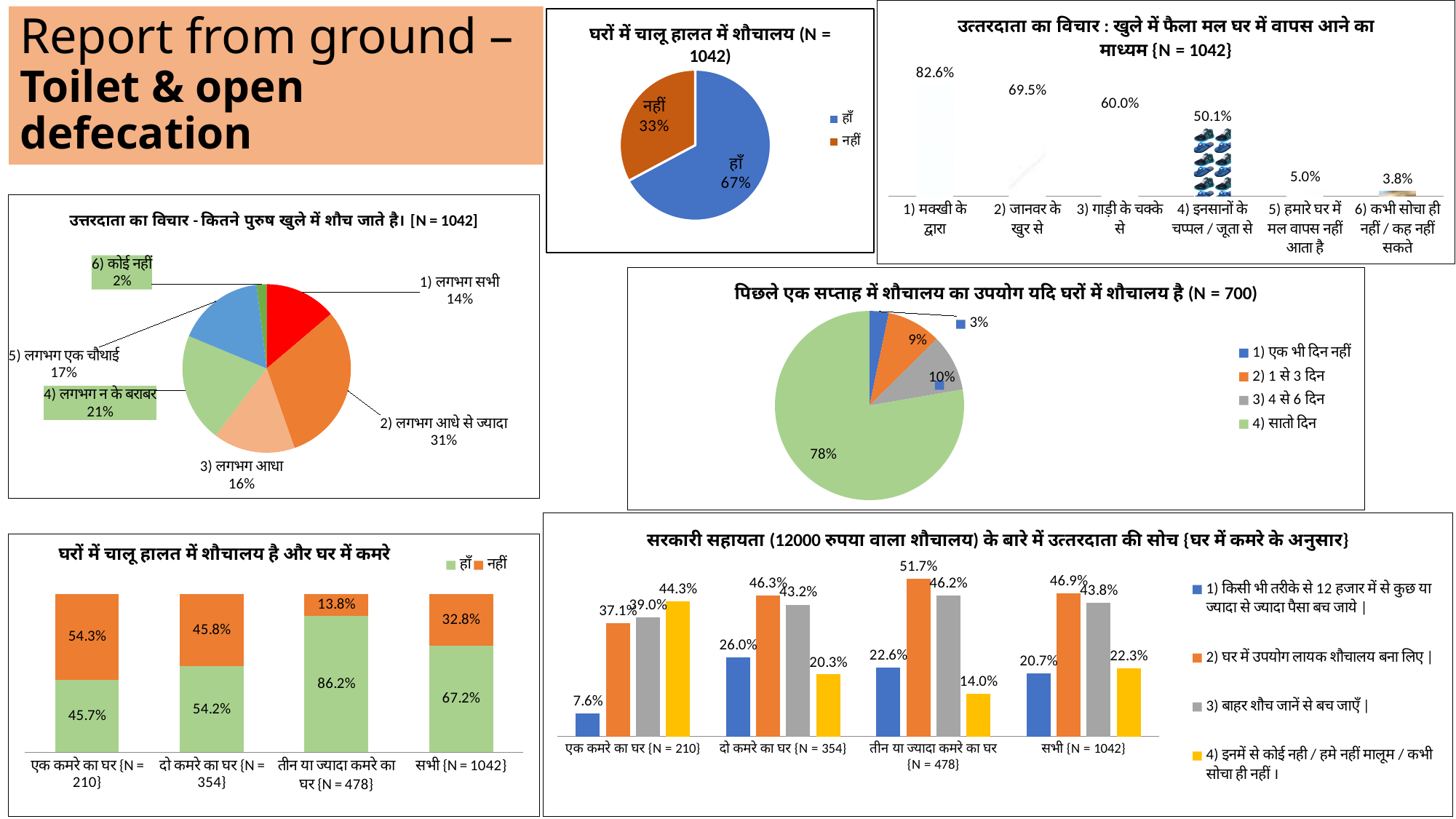
In the chart titled 'सरकारी सहायता (12000 रुपया वाला शौचालय) के बारे में उत्तरदाता की सोच', for 'एक कमरे का घर {N = 210}', which is larger: series 1 or series 4? Series 4 (44.3%) In the pie chart titled 'पिछले एक सप्ताह में शौचालय का उपयोग यदि घरों में शौचालय है (N = 700)', how many series does the legend list? 4 What kind of chart is 'घरों में चालू हालत में शौचालय है और घर में कमरे'? Stacked bar chart In the chart titled 'घरों में चालू हालत में शौचालय है और घर में कमरे', what is the difference between the 'नहीं' values for 'एक कमरे का घर {N = 210}' and 'सभी {N = 1042}'? 21.5% In the chart titled 'घरों में चालू हालत में शौचालय है और घर में कमरे', what is the 'हाँ' value for 'तीन या ज्यादा कमरे का घर {N = 478}'? 86.2% In the chart titled 'सरकारी सहायता (12000 रुपया वाला शौचालय) के बारे में उत्तरदाता की सोच', what is the value of series '2) घर में उपयोग लायक शौचालय बना लिए' for 'तीन या ज्यादा कमरे का घर {N = 478}'? 51.7% In the bar chart titled 'उत्तरदाता का विचार : खुले में फैला मल घर में वापस आने का माध्यम', what is the value for '1) मक्खी के द्वारा'? 82.6% In the pie chart titled 'उत्तरदाता का विचार - कितने पुरुष खुले में शौच जाते है।', how many slices are there? 6 In the pie chart titled 'उत्तरदाता का विचार - कितने पुरुष खुले में शौच जाते है।', which category has the largest share? 2) लगभग आधे से ज्यादा In the pie chart titled 'घरों में चालू हालत में शौचालय (N = 1042)', what percentage is shown for 'हाँ'? 67% In the bar chart titled 'उत्तरदाता का विचार : खुले में फैला मल घर में वापस आने का माध्यम', which category has the lowest value? 6) कभी सोचा ही नहीं / कह नहीं सकते In the pie chart titled 'पिछले एक सप्ताह में शौचालय का उपयोग यदि घरों में शौचालय है (N = 700)', what percentage is shown for '4) सातो दिन'? 78%